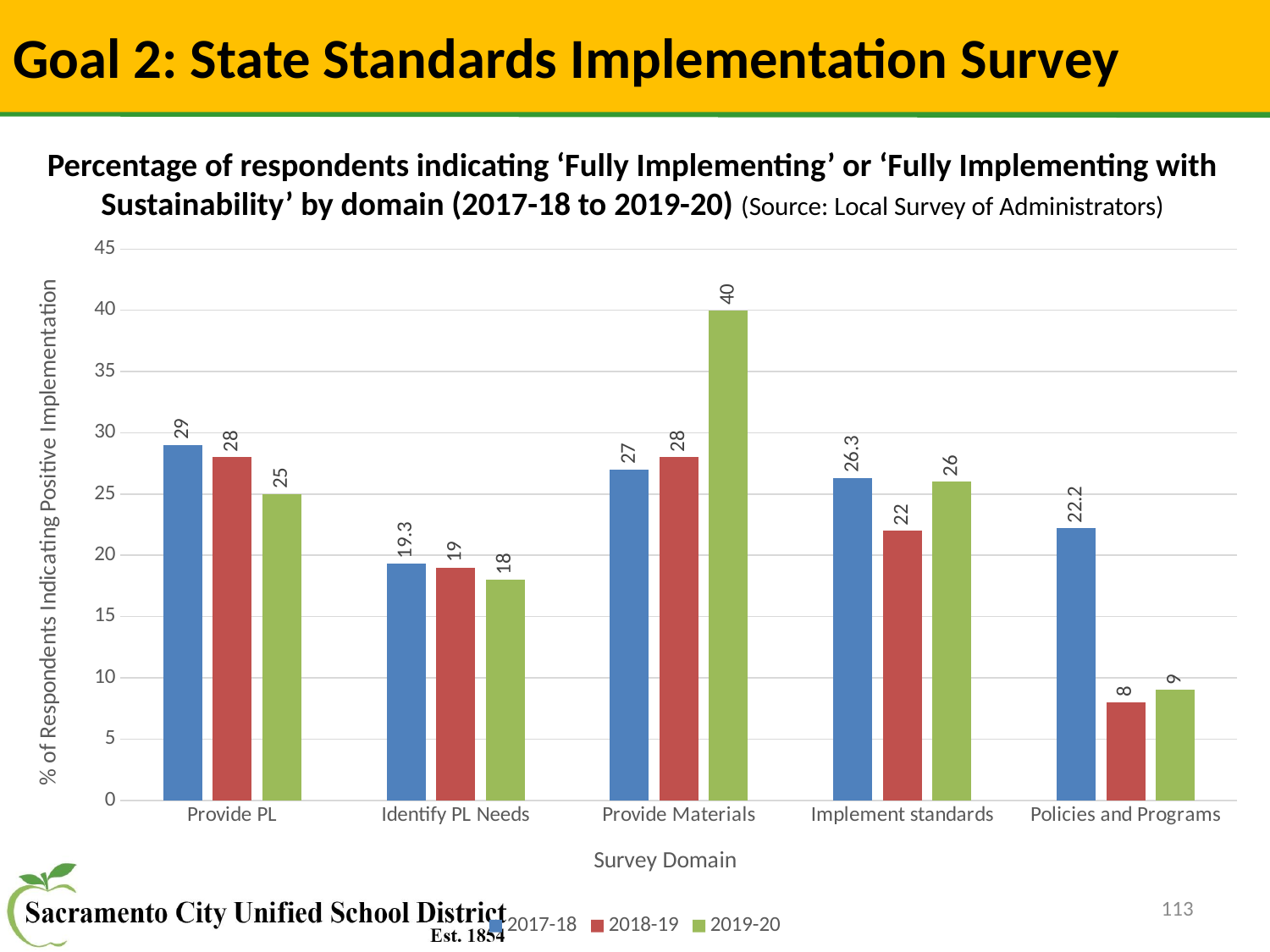
Which survey domain has the lowest value in 2018-19? Policies and Programs What is the difference between the 2017-18 and 2019-20 values for Policies and Programs? 13.2 What is the value for Policies and Programs in 2018-19? 8 What is the value for Implement standards in 2017-18? 26.3 Which survey domain has the highest value in 2019-20? Provide Materials Which colour represents the 2019-20 series? green What is the value for Provide Materials in 2019-20? 40 Which is larger for Identify PL Needs: the 2017-18 value or the 2019-20 value? 2017-18 What is the label of the y axis? % of Respondents Indicating Positive Implementation How many survey domains are shown on the x axis? 5 How many series does the legend list? 3 What kind of chart is shown on the slide? bar chart